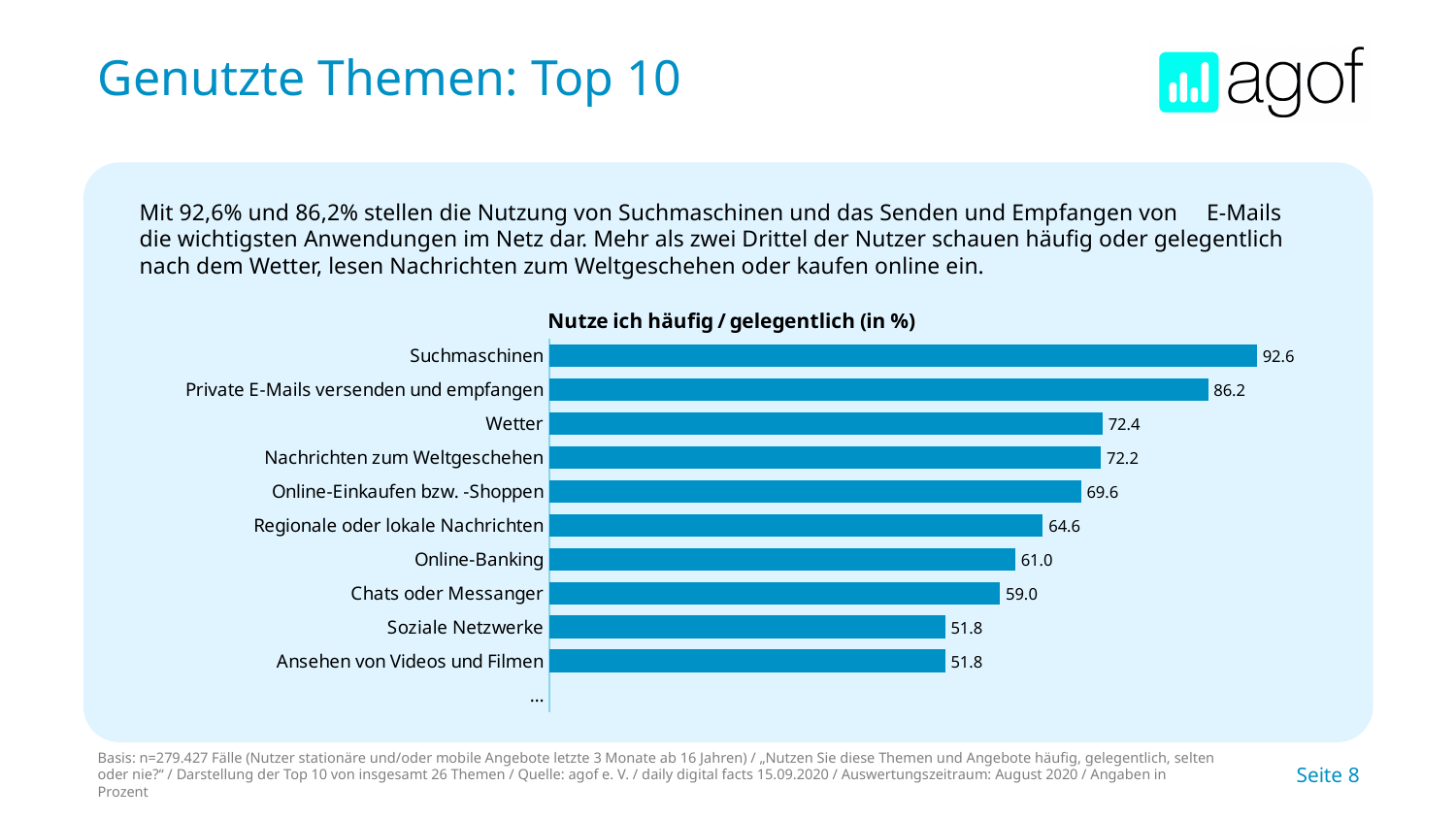
What is the value for Suchmaschinen? 92.6 What is the value for Online-Banking? 61.0 Which category has the highest value? Suchmaschinen What is the title of the chart? Nutze ich häufig / gelegentlich (in %) What is the difference between the values for Suchmaschinen and Private E-Mails versenden und empfangen? 6.4 What is the value for Regionale oder lokale Nachrichten? 64.6 What is the difference between the values for Online-Banking and Chats oder Messanger? 2.0 How many labelled categories with bars are shown in the chart? 10 Which is larger, the value for Online-Einkaufen bzw. -Shoppen or the value for Regionale oder lokale Nachrichten? Online-Einkaufen bzw. -Shoppen Which is larger, the value for Wetter or the value for Online-Banking? Wetter What is the value for Soziale Netzwerke? 51.8 What kind of chart is shown on the slide? Bar chart